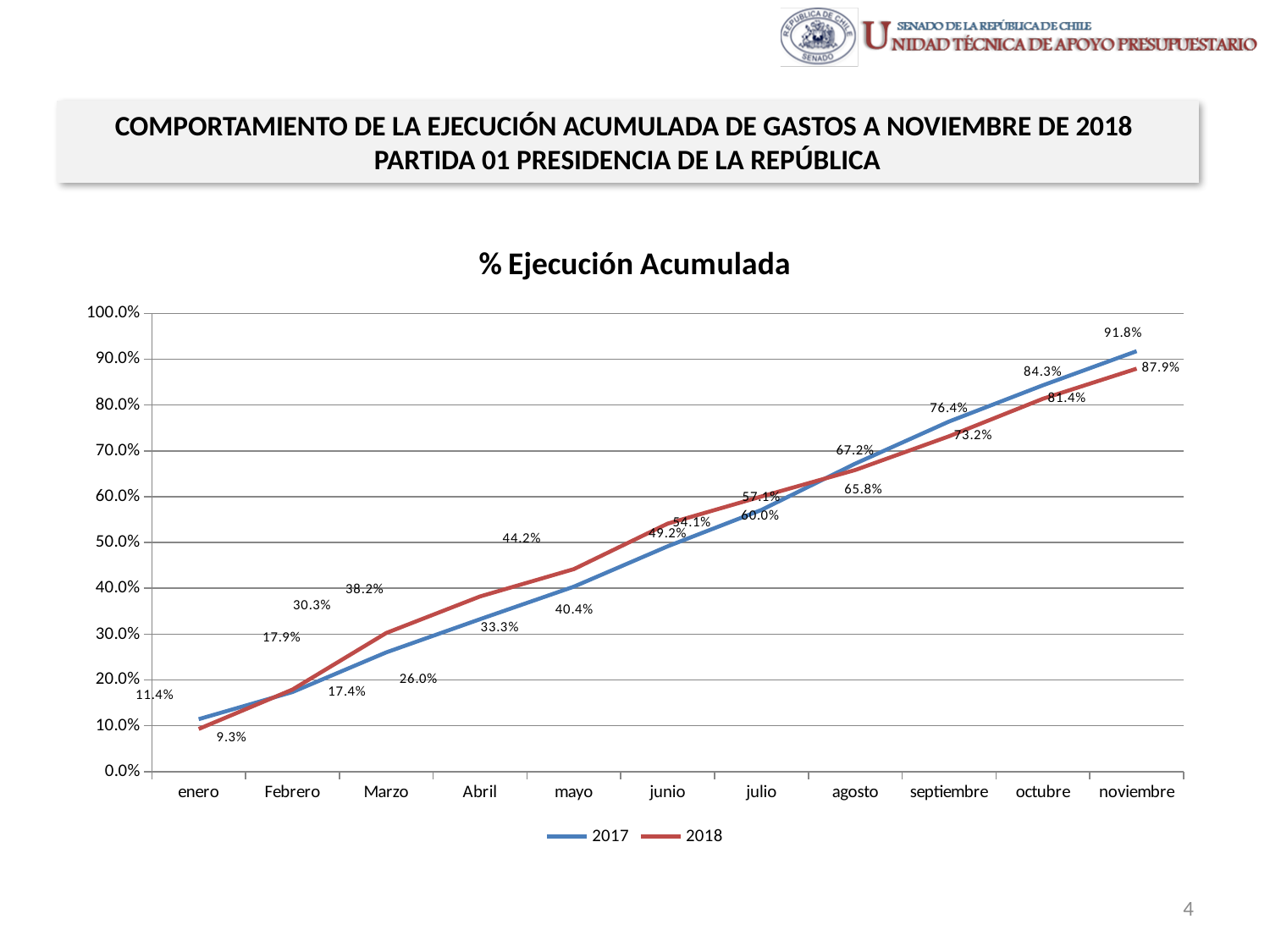
Do the values for 2018 rise or fall from enero to noviembre? rise What is the difference between the 2017 and 2018 values in noviembre? 3.9% Which series has the higher value in Marzo, 2017 or 2018? 2018 What type of chart is shown on the slide? line chart What is the value for 2018 in enero? 9.3% What is the title of the chart? % Ejecución Acumulada In which month is the 2017 series at its lowest? enero How many series does the legend list? 2 What is the value for 2018 in noviembre? 87.9% How many months are plotted along the x axis? 11 What is the value for 2017 in noviembre? 91.8% What is the value for 2017 in mayo? 40.4%